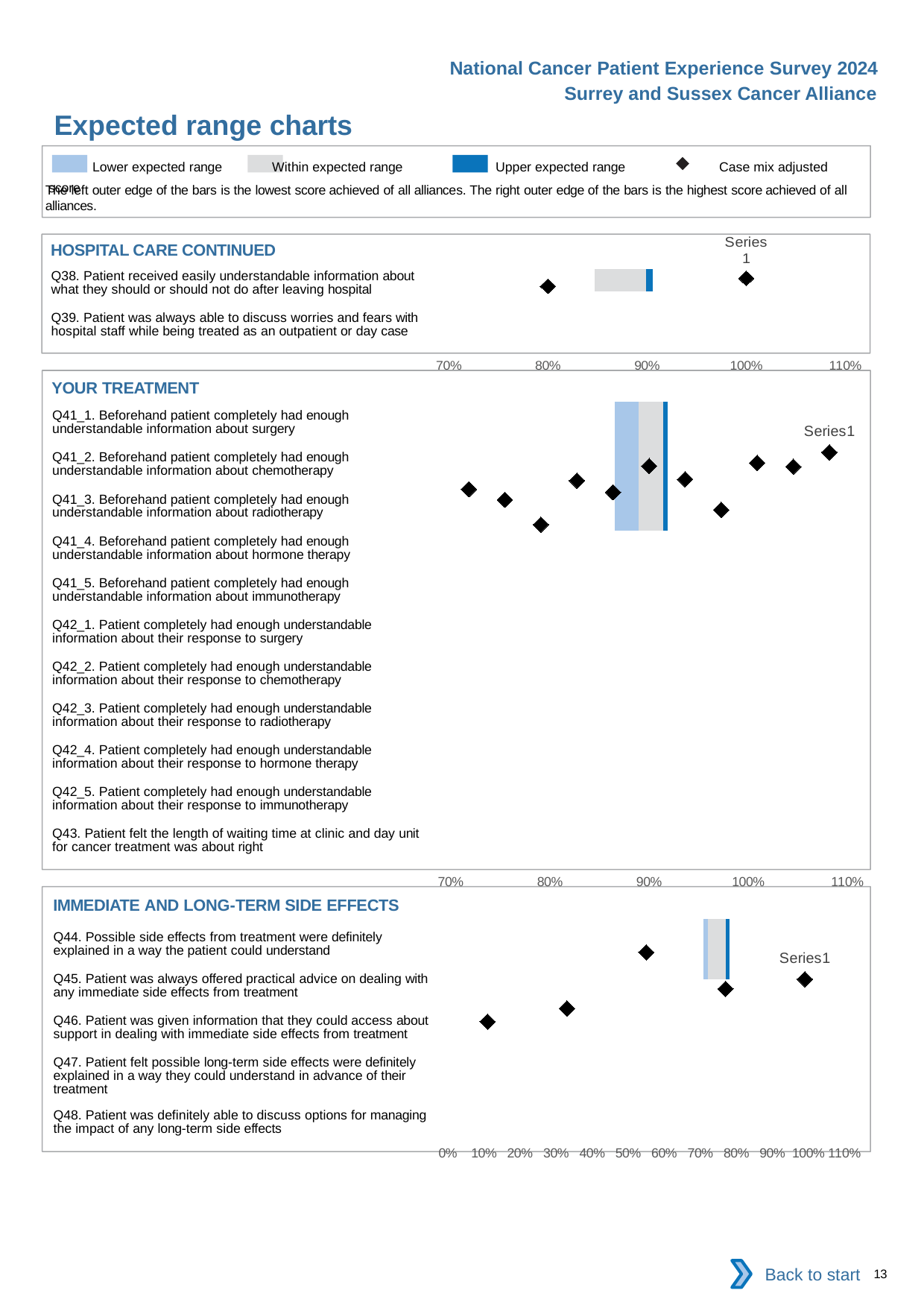
What is the highest axis tick shown on the YOUR TREATMENT chart? 110% In the IMMEDIATE AND LONG-TERM SIDE EFFECTS chart, is the leftmost plotted marker greater or less than 50%? less What is the lowest axis tick shown on the HOSPITAL CARE CONTINUED chart? 70% How many charts are shown on the slide? 3 How many question items are listed in the IMMEDIATE AND LONG-TERM SIDE EFFECTS chart? 5 How many series does the legend of the YOUR TREATMENT chart list? 1 In the YOUR TREATMENT chart, is the leftmost plotted marker greater or less than 80%? less What is the title of the middle chart on the slide? YOUR TREATMENT What is the legend entry shown on the IMMEDIATE AND LONG-TERM SIDE EFFECTS chart? Series1